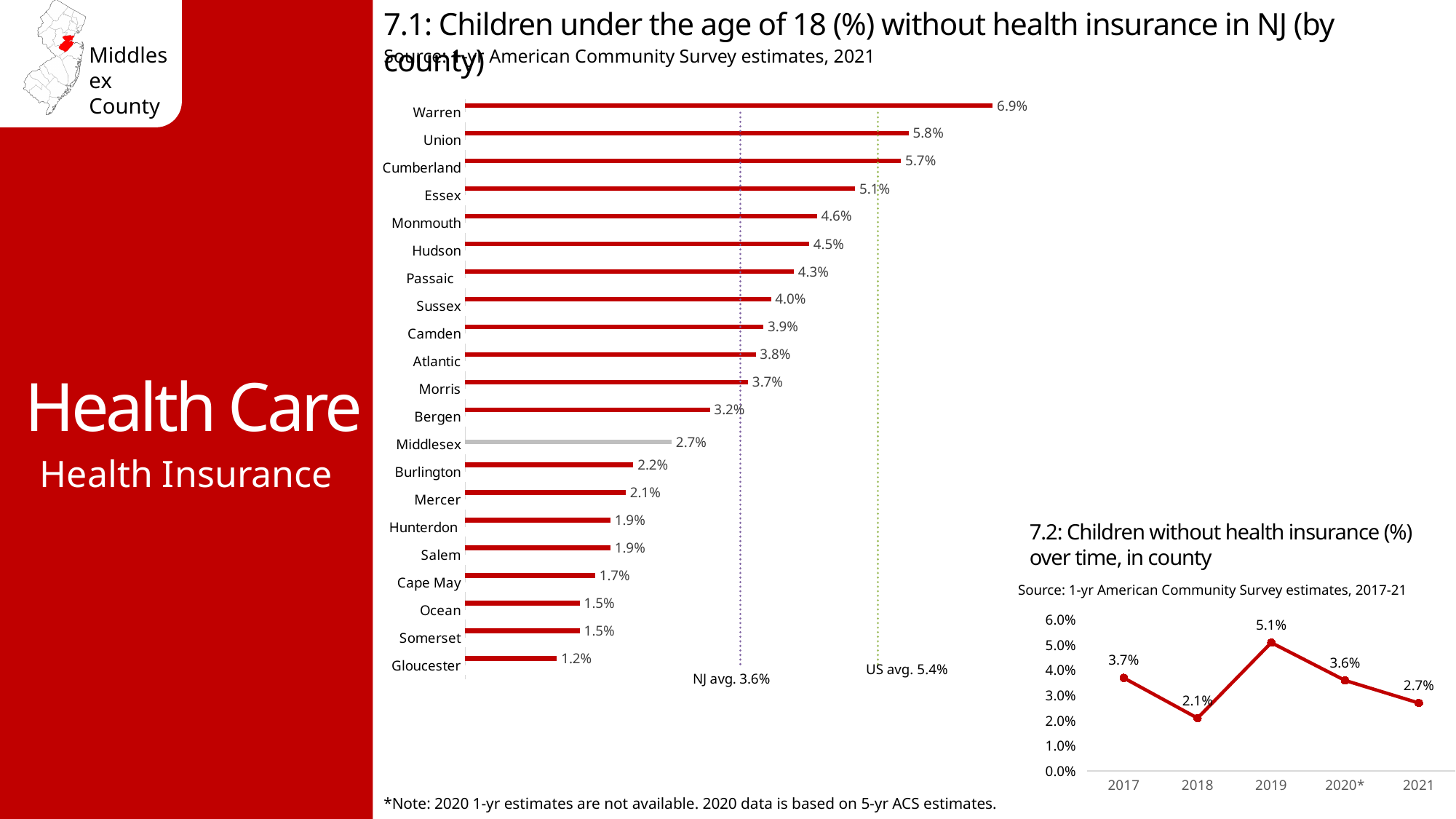
In chart 7.1, what is the difference between the values for Warren and Gloucester? 5.7% In chart 7.1, which county has the lowest percentage of children without health insurance? Gloucester In chart 7.1, what is the NJ average shown by the dotted reference line? 3.6% In chart 7.1, which county has a larger value, Hudson or Passaic? Hudson What type of chart is chart 7.2? Line chart In chart 7.1, how many counties are shown? 21 In chart 7.2 (children without health insurance over time), what is the value for 2019? 5.1% In chart 7.2, which year has the lowest value? 2018 In chart 7.2, what is the difference between the 2019 and 2021 values? 2.4% What type of chart is chart 7.1? Bar chart In chart 7.1 (children under 18 without health insurance by county), what is the value for Middlesex? 2.7% In chart 7.1, which county has the highest percentage of children without health insurance? Warren